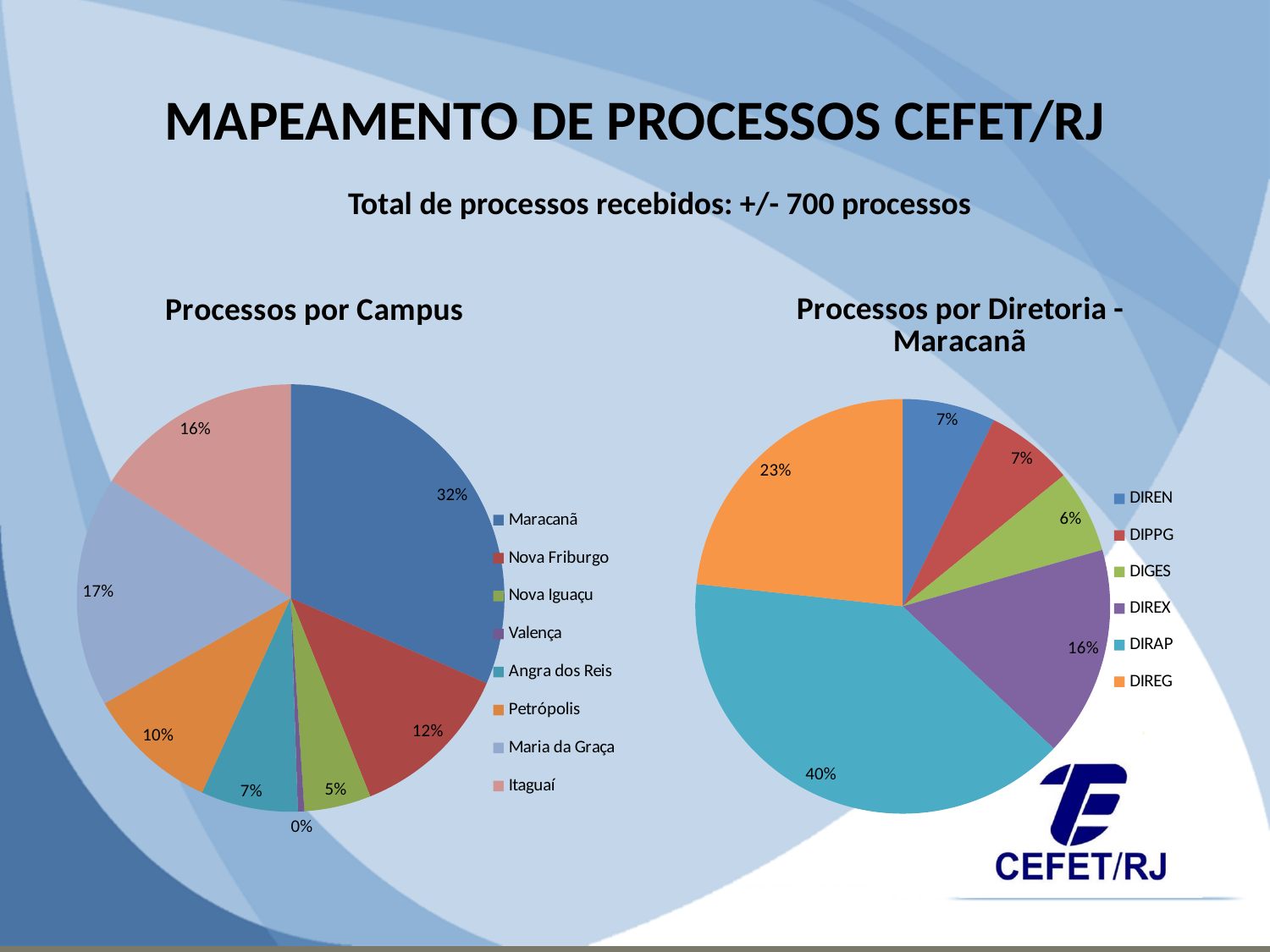
In the 'Processos por Campus' chart, how many campuses are listed in the legend? 8 What type of chart is 'Processos por Diretoria - Maracanã'? Pie chart In the 'Processos por Campus' chart, what is the share for Maria da Graça? 17% In the 'Processos por Diretoria - Maracanã' chart, what share does DIREG have? 23% In the 'Processos por Campus' chart, which campus has the smallest share? Valença In the 'Processos por Campus' chart, which campus has the largest share? Maracanã In the 'Processos por Campus' chart, which is larger, Petrópolis or Angra dos Reis? Petrópolis In the 'Processos por Diretoria - Maracanã' chart, how many diretorias are listed in the legend? 6 In the 'Processos por Campus' chart, what is the difference between the shares of Nova Friburgo and Nova Iguaçu? 7% In the 'Processos por Diretoria - Maracanã' chart, which diretoria has the largest share? DIRAP In the 'Processos por Diretoria - Maracanã' chart, what is the share for DIREX? 16% In the 'Processos por Campus' chart, what share does Maracanã have? 32%